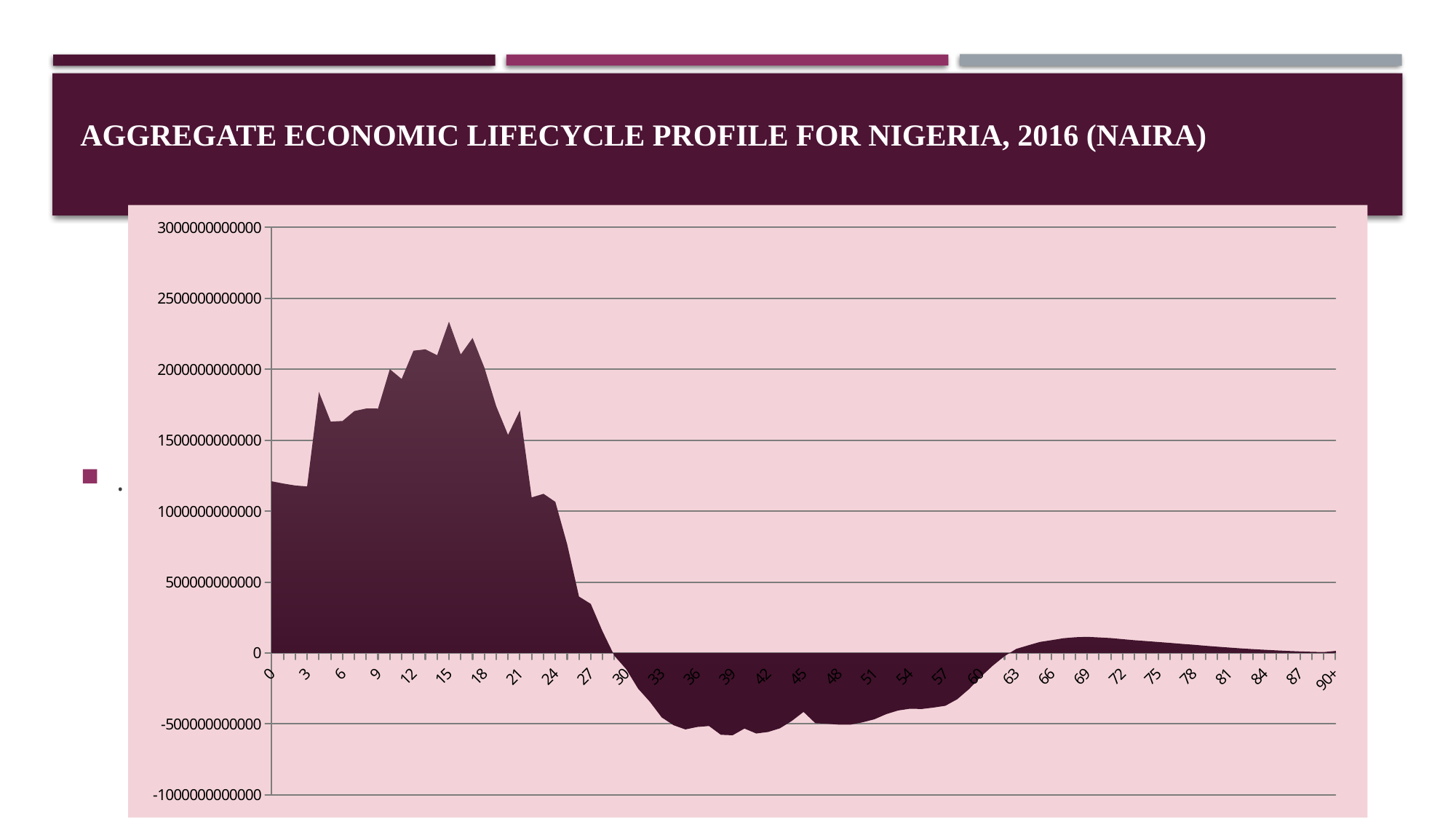
What kind of chart is shown on the slide? Area chart Is the value at age 48 greater or less than 0? less Is the highest value of the profile reached before or after age 30? Before Is the value at age 15 greater or less than 20000000000000? greater Which has the larger value, age 36 or age 69? Age 69 Which has the larger value, age 6 or age 12? Age 12 What is the title of the slide's chart? Aggregate Economic Lifecycle Profile for Nigeria, 2016 (Naira) What is the highest value shown on the vertical axis? 30000000000000 Is the value at age 39 greater or less than 0? less Do the values rise or fall between age 18 and age 30? Fall